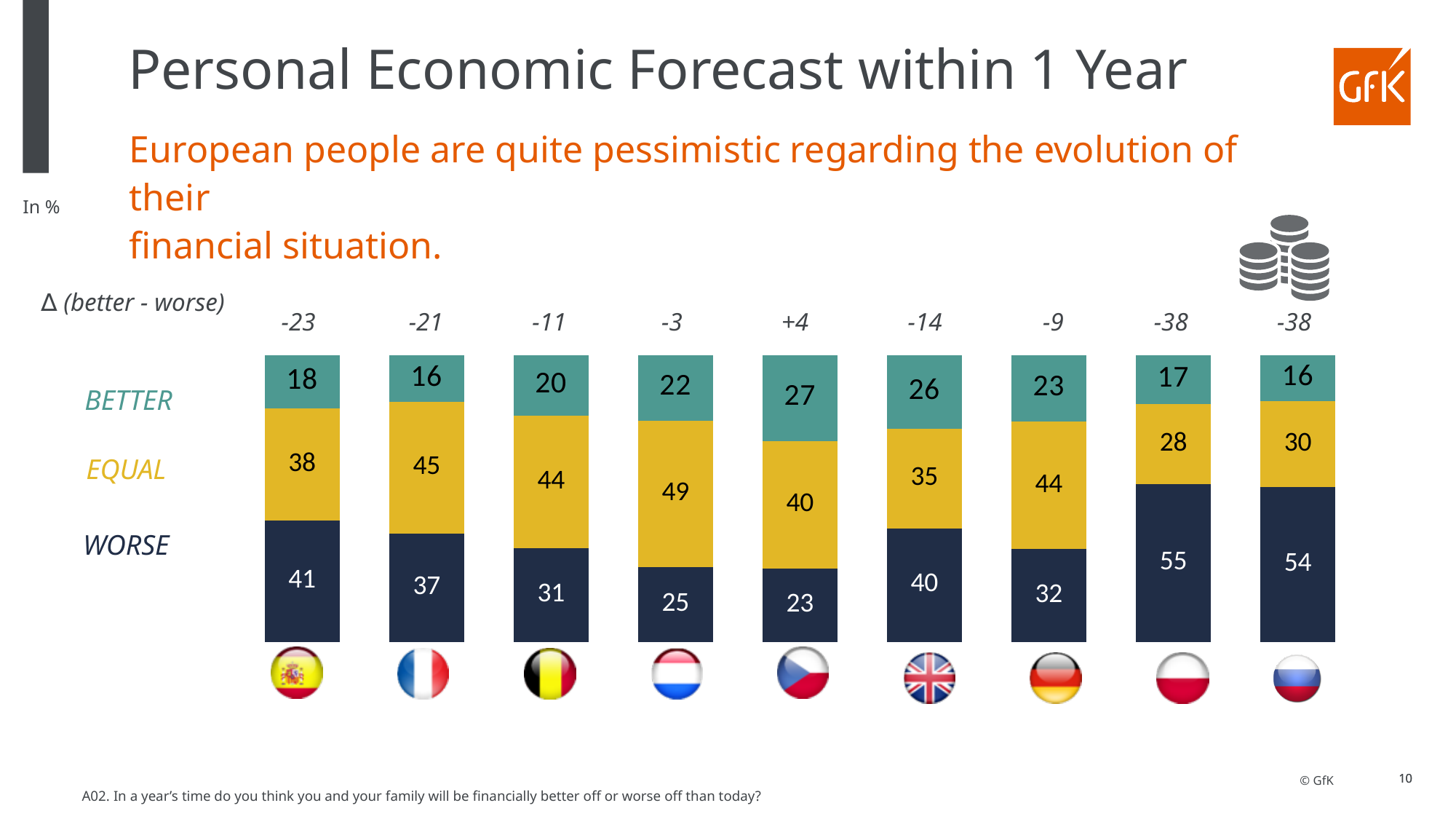
What is the EQUAL value for the fourth bar from the left? 49 Which bar has the lowest WORSE value? the fifth bar from the left (23) What kind of chart is shown on the slide? stacked bar chart How many series does the chart's legend list? 3 Which bar has the highest WORSE value? the eighth bar from the left (55) What is the title of the chart on the slide? Personal Economic Forecast within 1 Year What is the WORSE value for the first bar from the left? 41 How many bars (countries) are plotted in the chart? 9 What is the BETTER value for the fifth bar from the left? 27 What is the total of the three segments in the first bar from the left? 97 Which is larger, the EQUAL value of the second bar or the EQUAL value of the third bar from the left? the second bar (45) What is the difference between the WORSE values of the eighth and ninth bars from the left? 1